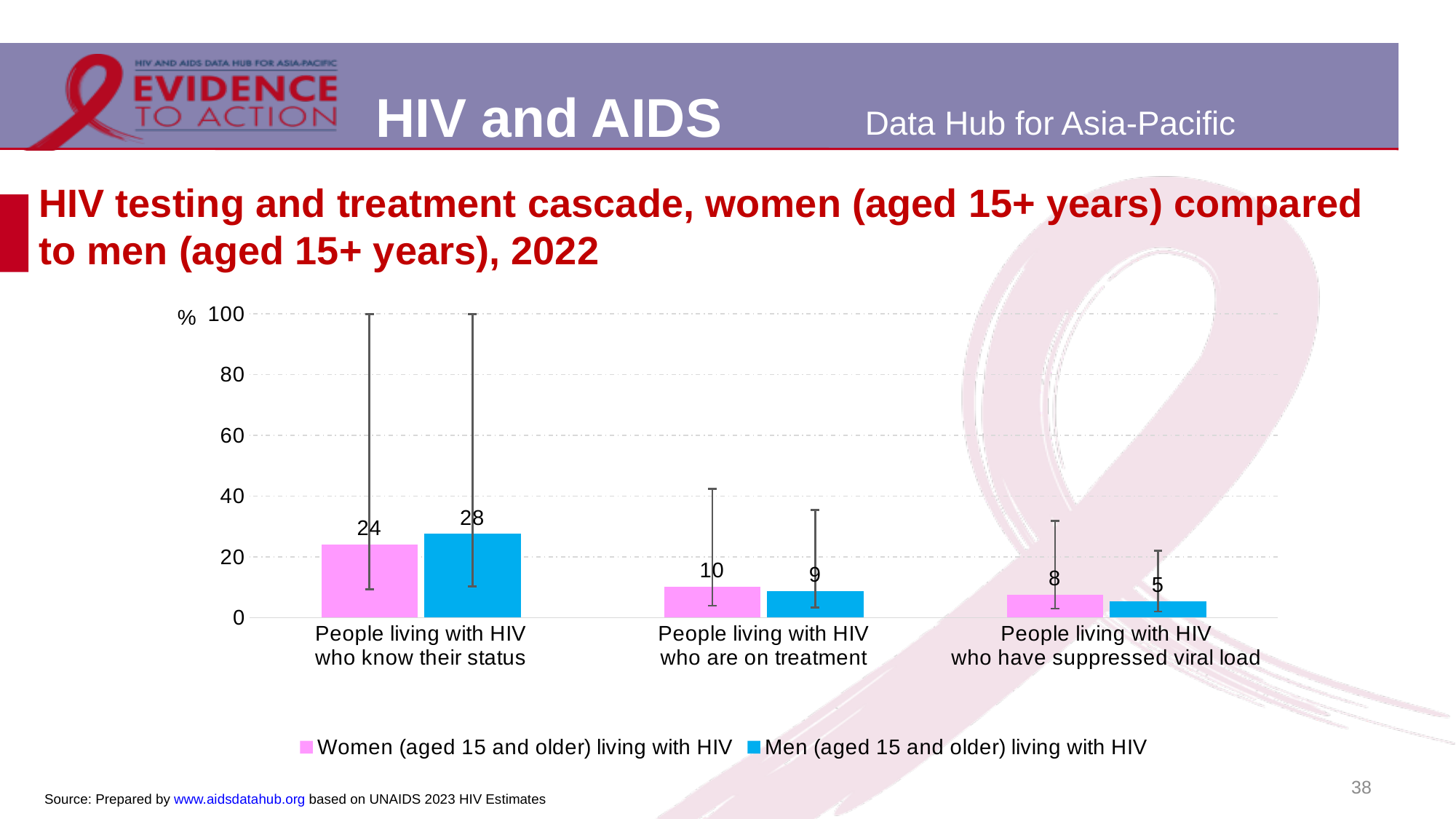
Do the values for women fall or rise across the categories from left to right? Fall For people living with HIV who have suppressed viral load, which is larger: the value for women or for men? Women What is the value for men living with HIV who are on treatment? 9 Which category has the highest value for men (aged 15 and older) living with HIV? People living with HIV who know their status How many categories are shown on the x axis? 3 What is the difference between the men's and women's values for people living with HIV who know their status? 4 What is the value for women living with HIV who know their status? 24 How many series does the legend list? 2 What is the value for men living with HIV who have suppressed viral load? 5 Is the value for men living with HIV who know their status greater or less than 40? less Which category has the lowest value for women (aged 15 and older) living with HIV? People living with HIV who have suppressed viral load What kind of chart is shown on the slide? Bar chart